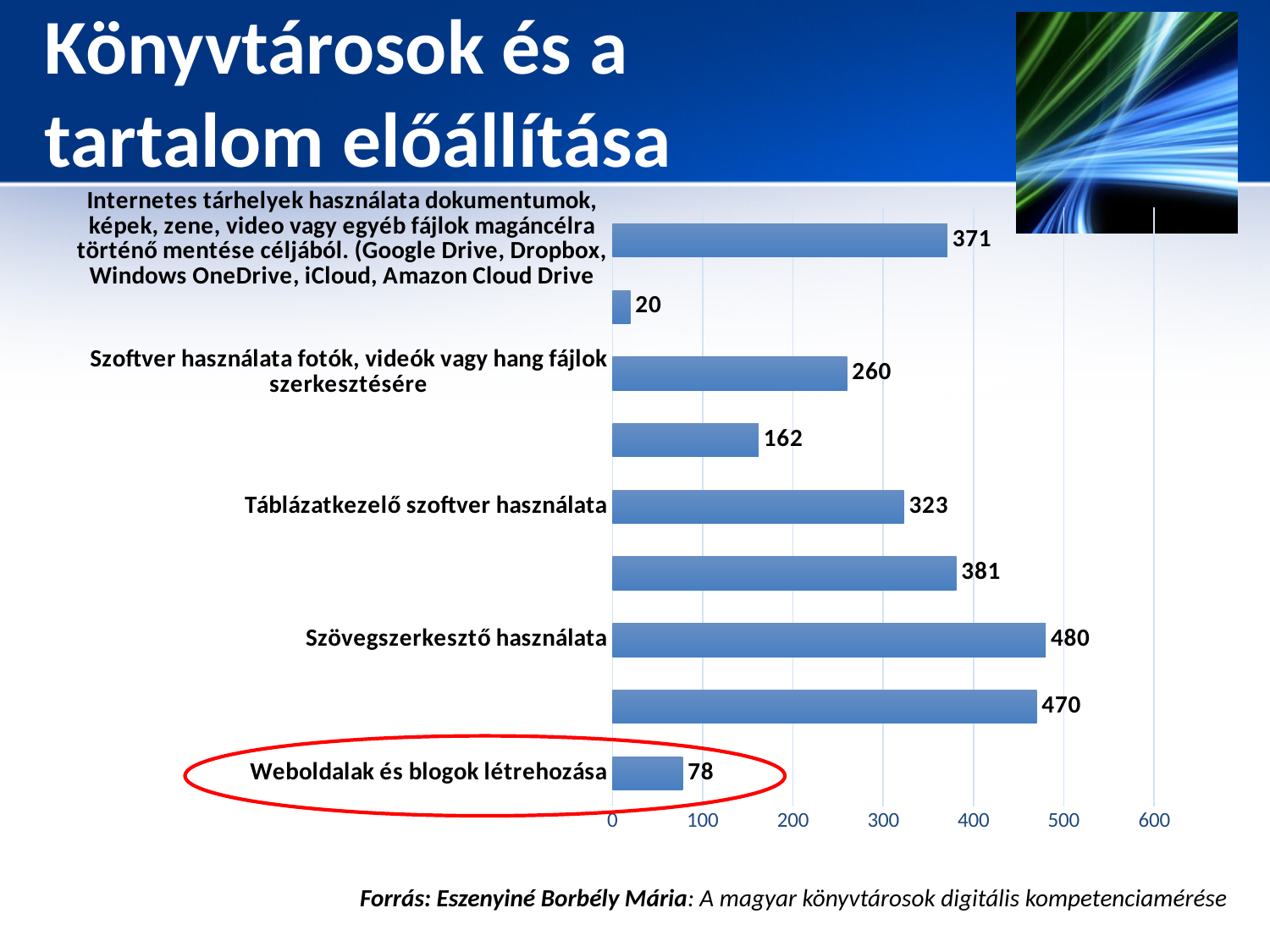
What kind of chart is shown on the slide? bar chart Which category on the chart is circled in red? Weboldalak és blogok létrehozása What is the lowest value shown on the chart? 20 What is the value for "Weboldalak és blogok létrehozása"? 78 What is the value for "Szoftver használata fotók, videók vagy hang fájlok szerkesztésére"? 260 What is the value for "Táblázatkezelő szoftver használata"? 323 Which is larger: the value for "Táblázatkezelő szoftver használata" or the value for "Szoftver használata fotók, videók vagy hang fájlok szerkesztésére"? Táblázatkezelő szoftver használata How many bars are plotted on the chart? 9 Which category has the highest value? Szövegszerkesztő használata What is the difference between the values for "Szövegszerkesztő használata" and "Weboldalak és blogok létrehozása"? 402 What is the value for "Szövegszerkesztő használata"? 480 What is the value for the category about using internet storage (Google Drive, Dropbox, etc.)? 371